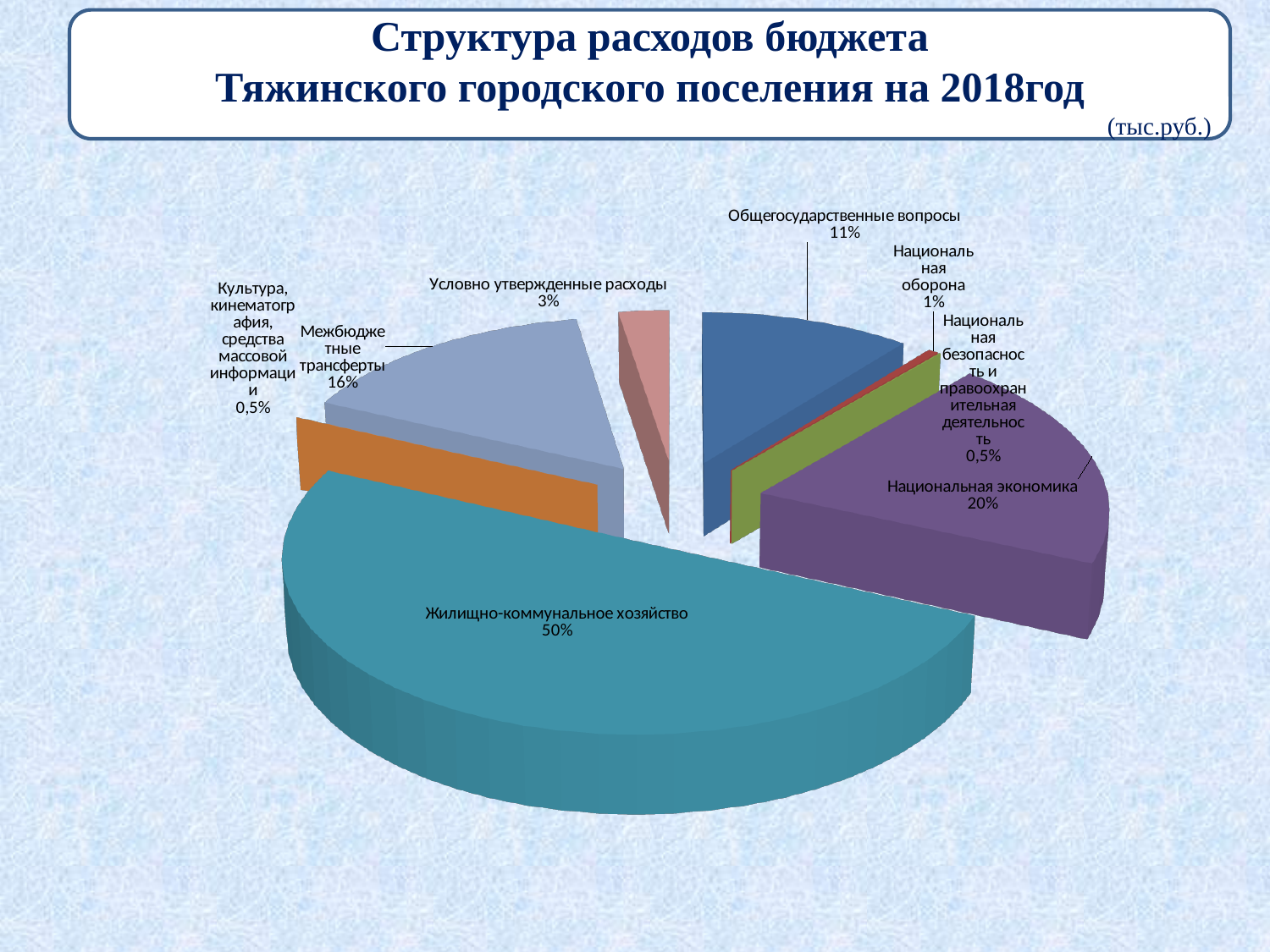
What share of the budget expenditure is Общегосударственные вопросы? 11% What share of the budget expenditure is Национальная оборона? 1% What share of the budget expenditure is Жилищно-коммунальное хозяйство? 50% How many categories (slices) does the pie chart show? 8 Which is larger: the share for Национальная экономика or the share for Межбюджетные трансферты? Национальная экономика What is the difference in percentage points between the share for Жилищно-коммунальное хозяйство and the share for Национальная экономика? 30 percentage points Which category has the largest share of the budget expenditure? Жилищно-коммунальное хозяйство What is the title of the chart on the slide? Структура расходов бюджета Тяжинского городского поселения на 2018год What kind of chart is shown on the slide? Pie chart